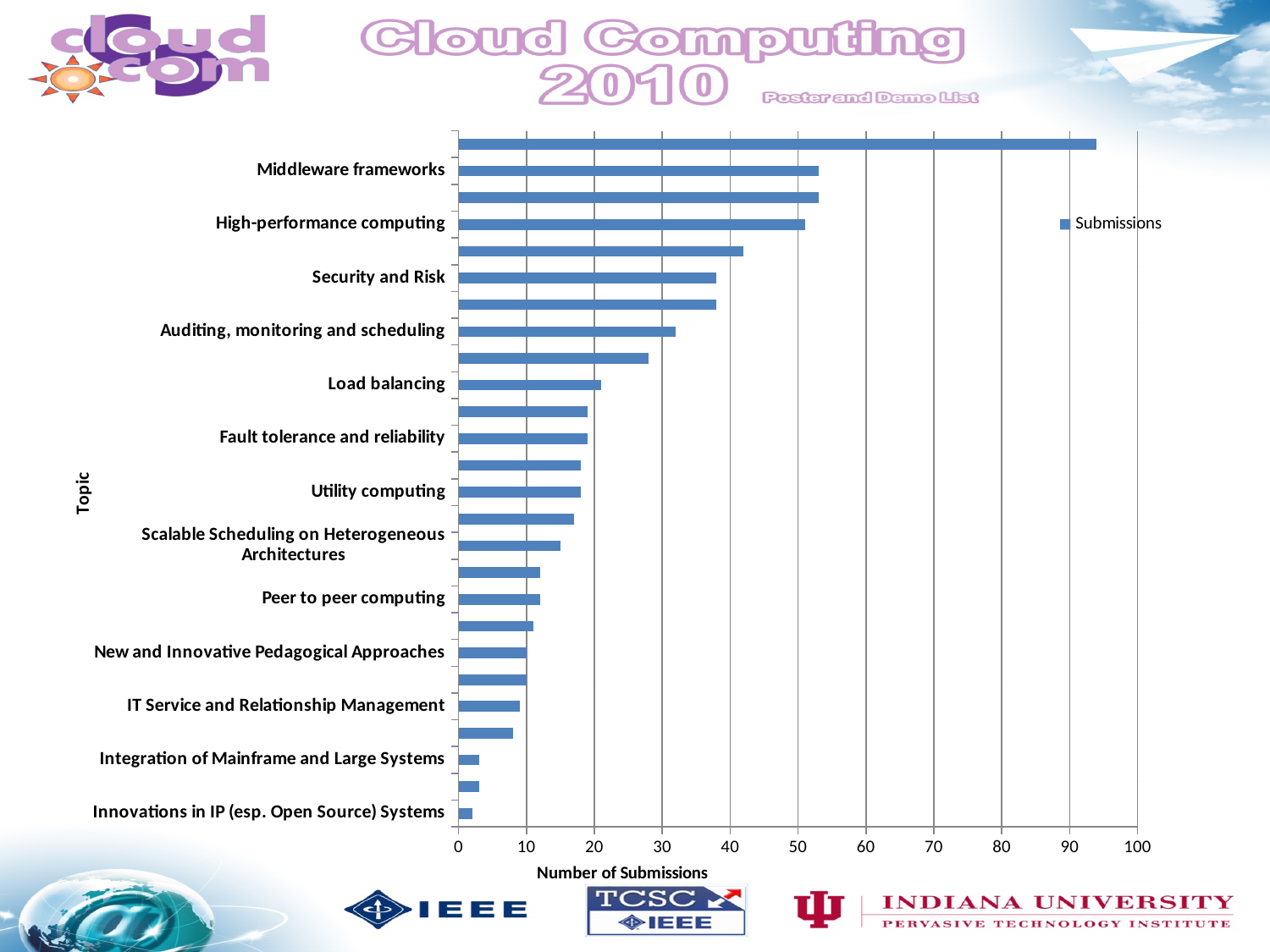
Which has more submissions, Load balancing or Peer to peer computing? Load balancing Which labeled topic has the lowest number of submissions? Innovations in IP (esp. Open Source) Systems Which has more submissions, Middleware frameworks or Security and Risk? Middleware frameworks Is the value for Innovations in IP (esp. Open Source) Systems greater or less than 10? less Is the value for Middleware frameworks greater or less than 50? greater What is the name of the series shown in the legend? Submissions Is the value for Security and Risk greater or less than 40? less What is the title of the horizontal axis? Number of Submissions What kind of chart is shown on the slide? Bar chart How many series does the legend list? 1